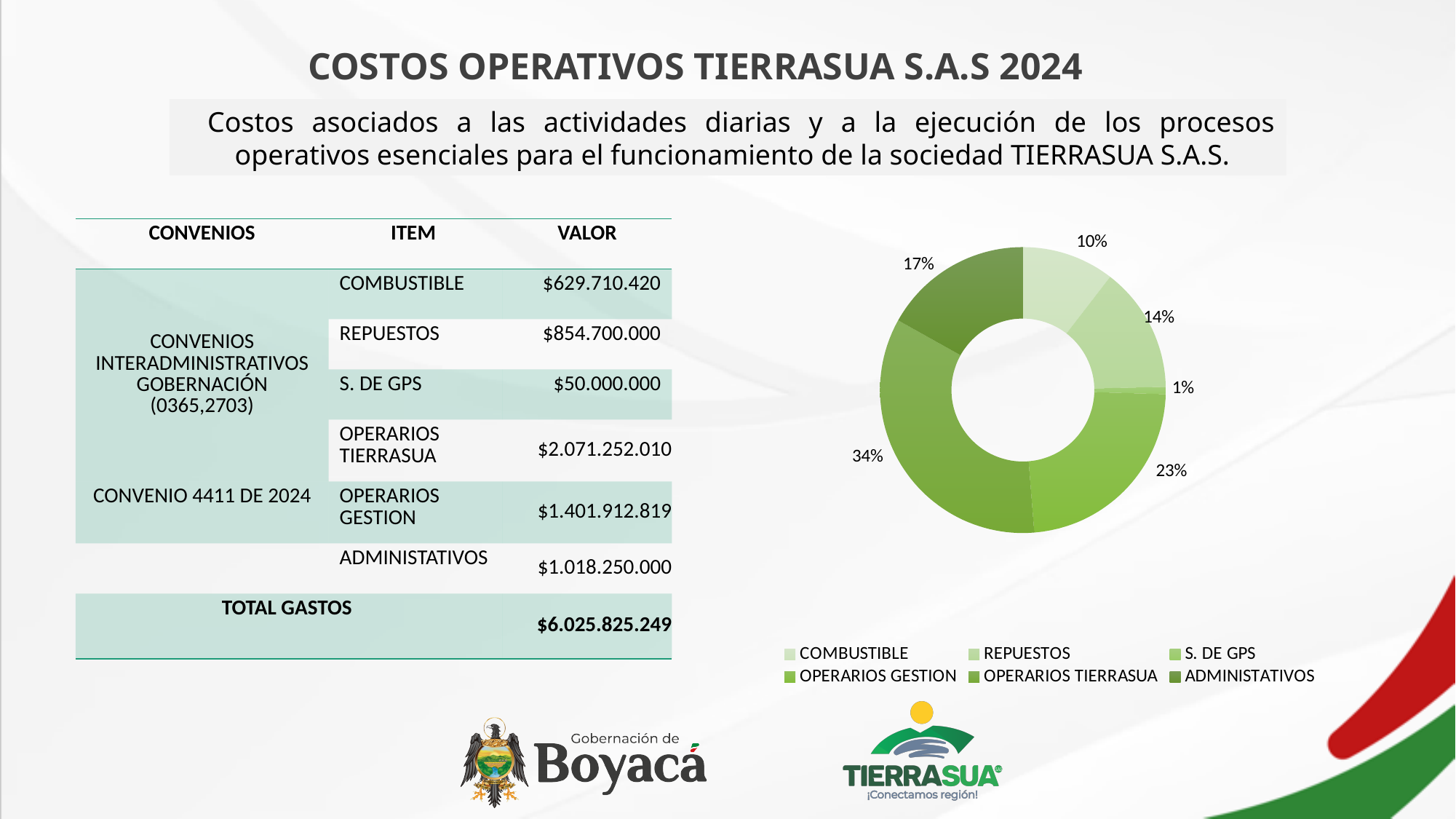
In the pie chart, what is the difference in percentage points between OPERARIOS TIERRASUA and OPERARIOS GESTION? 11 percentage points What share of the pie chart does COMBUSTIBLE represent? 10% Which category has the largest slice in the pie chart? OPERARIOS TIERRASUA In the pie chart, which is larger: the share for REPUESTOS or the share for ADMINISTATIVOS? ADMINISTATIVOS How many categories does the legend of the pie chart list? 6 What share of the pie chart does ADMINISTATIVOS represent? 17% What share of the pie chart does OPERARIOS TIERRASUA represent? 34% Which category has the smallest slice in the pie chart? S. DE GPS What kind of chart is shown on the slide? Pie chart (donut)